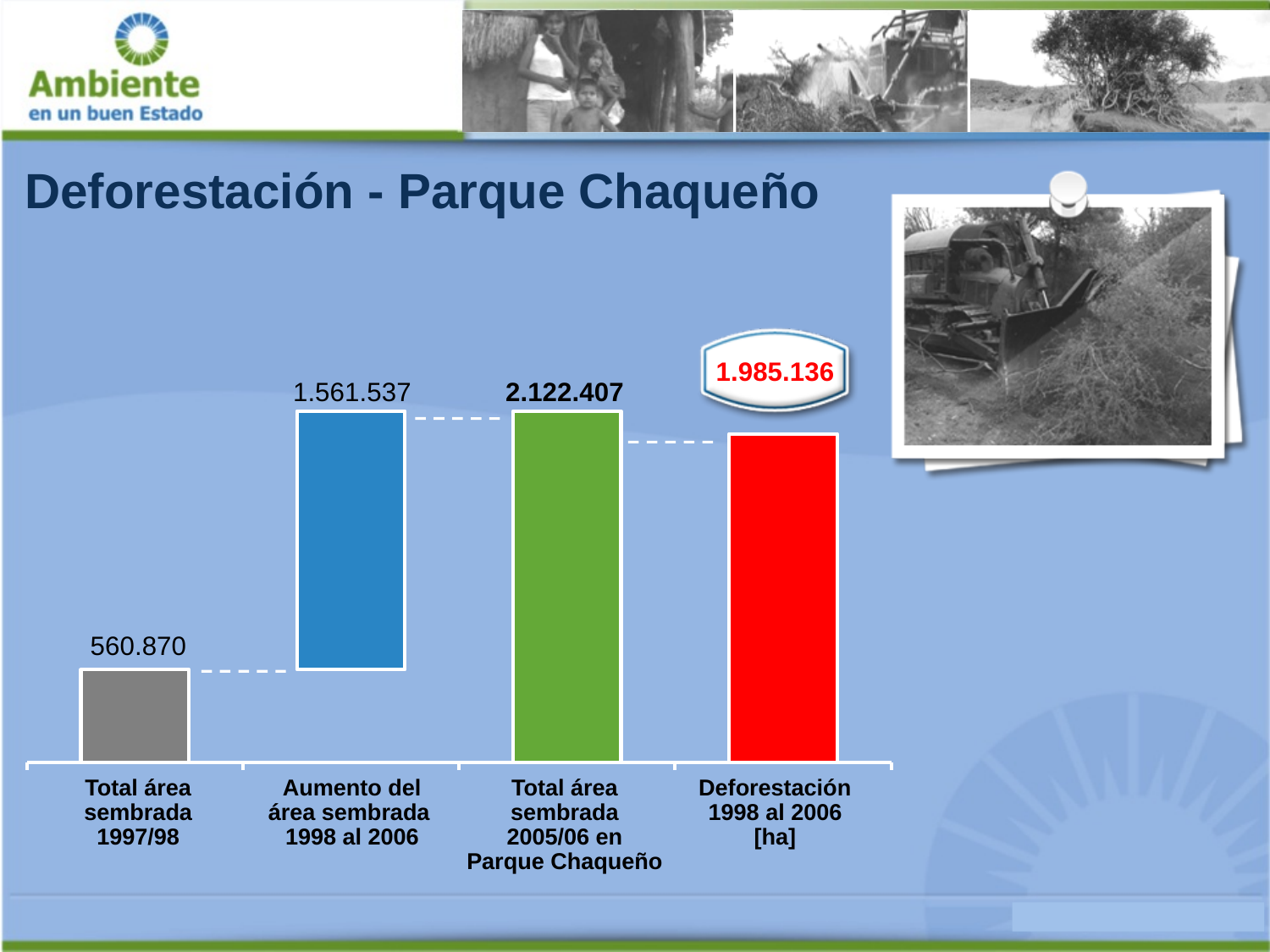
What is the value shown for 'Total área sembrada 2005/06 en Parque Chaqueño'? 2.122.407 Which category has the highest value? Total área sembrada 2005/06 en Parque Chaqueño What is the difference between 'Total área sembrada 2005/06 en Parque Chaqueño' and 'Deforestación 1998 al 2006 [ha]'? 137.271 What is the value shown for 'Aumento del área sembrada 1998 al 2006'? 1.561.537 What is the value shown for 'Deforestación 1998 al 2006 [ha]'? 1.985.136 What is the difference between 'Aumento del área sembrada 1998 al 2006' and 'Total área sembrada 1997/98'? 1.000.667 What kind of chart is shown on the slide? Bar chart How many bars are shown in the chart? 4 What is the value shown for 'Total área sembrada 1997/98'? 560.870 What colour is the bar for 'Deforestación 1998 al 2006 [ha]'? Red Which is larger: 'Deforestación 1998 al 2006 [ha]' or 'Aumento del área sembrada 1998 al 2006'? Deforestación 1998 al 2006 [ha] Which category has the lowest value? Total área sembrada 1997/98